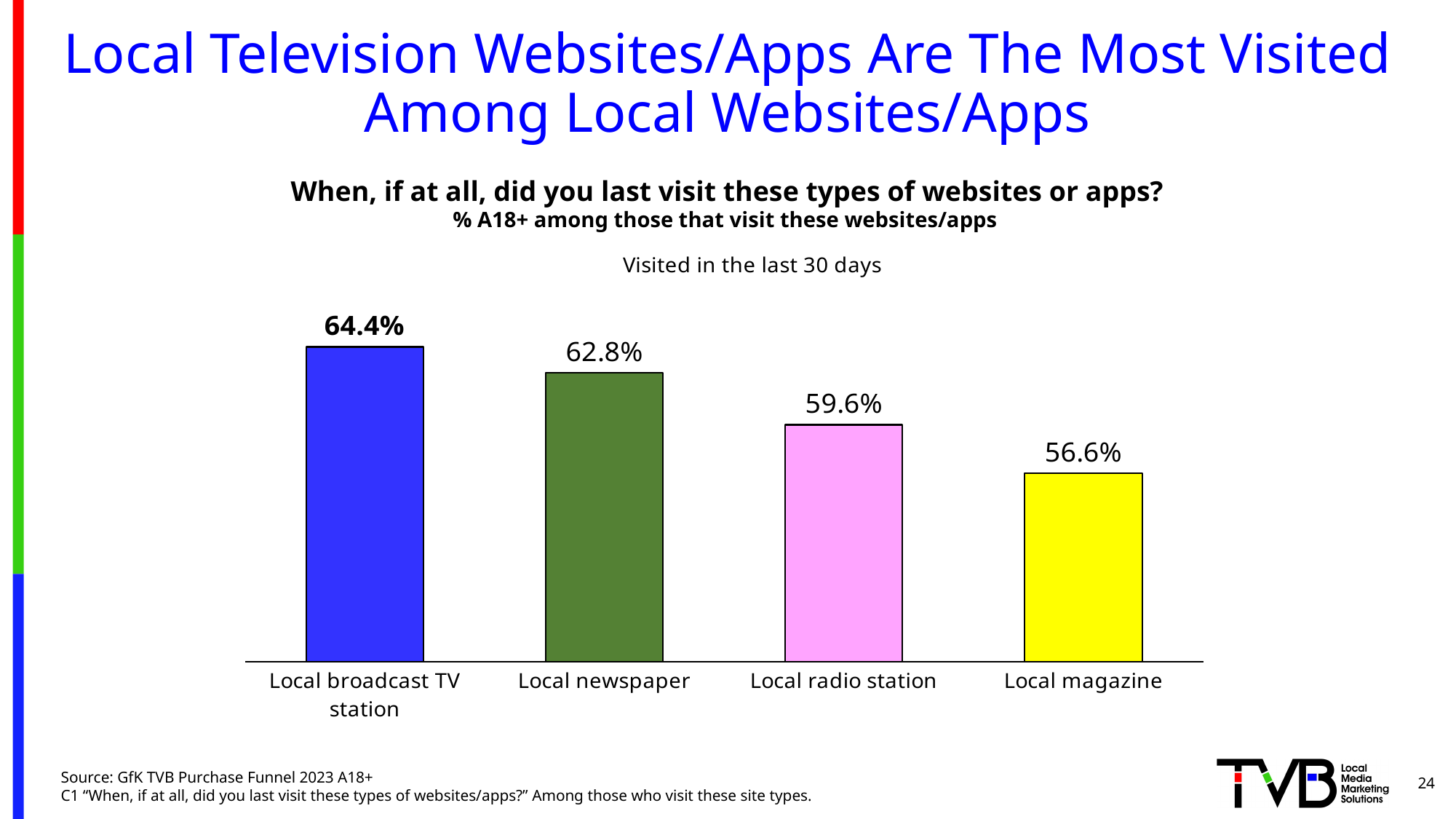
What is the value for Local newspaper? 62.8% What is the difference between the values for Local newspaper and Local radio station? 3.2 percentage points What is the value for Local radio station? 59.6% What kind of chart is shown on the slide? Bar chart Which is larger, the value for Local radio station or the value for Local magazine? Local radio station What is the value for Local magazine? 56.6% How many categories are shown in the chart? 4 Which category has the highest value? Local broadcast TV station What is the value for Local broadcast TV station? 64.4% What is the difference between the values for Local broadcast TV station and Local magazine? 7.8 percentage points What is the title of the chart? Visited in the last 30 days Which category has the lowest value? Local magazine